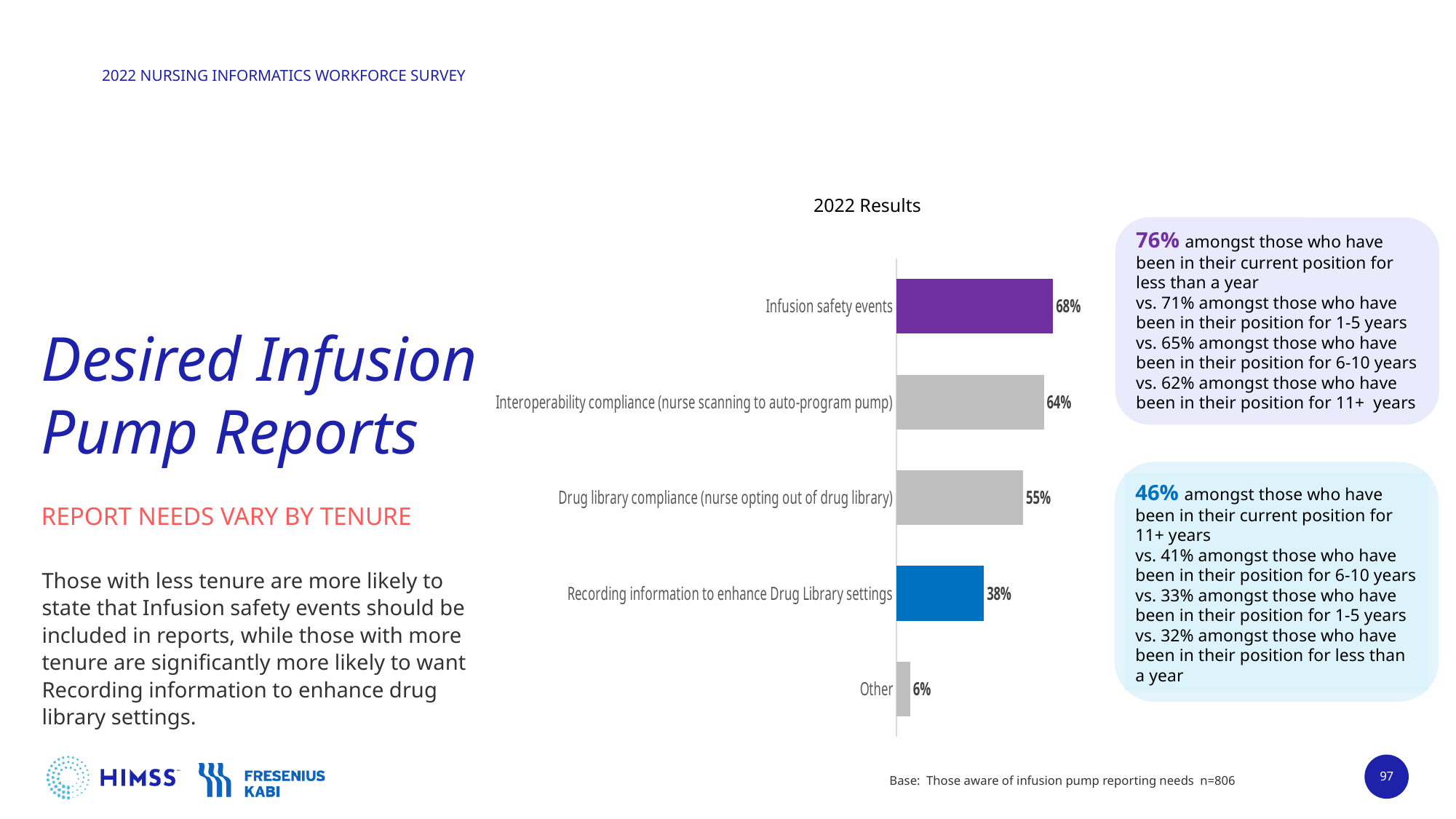
What is the difference between the values for Infusion safety events and Recording information to enhance Drug Library settings? 30 percentage points Which category has the highest value in the chart? Infusion safety events What is the value for Interoperability compliance (nurse scanning to auto-program pump)? 64% What is the title shown above the chart? 2022 Results Which category has the lowest value in the chart? Other Which is larger: the value for Interoperability compliance or the value for Drug library compliance? Interoperability compliance What percentage of respondents want Infusion safety events included in infusion pump reports? 68% What kind of chart is shown on the slide? Bar chart What percentage of respondents want Recording information to enhance Drug Library settings? 38% What is the difference between the values for Interoperability compliance and Other? 58 percentage points How many categories are shown in the chart? 5 What is the value for Drug library compliance (nurse opting out of drug library)? 55%